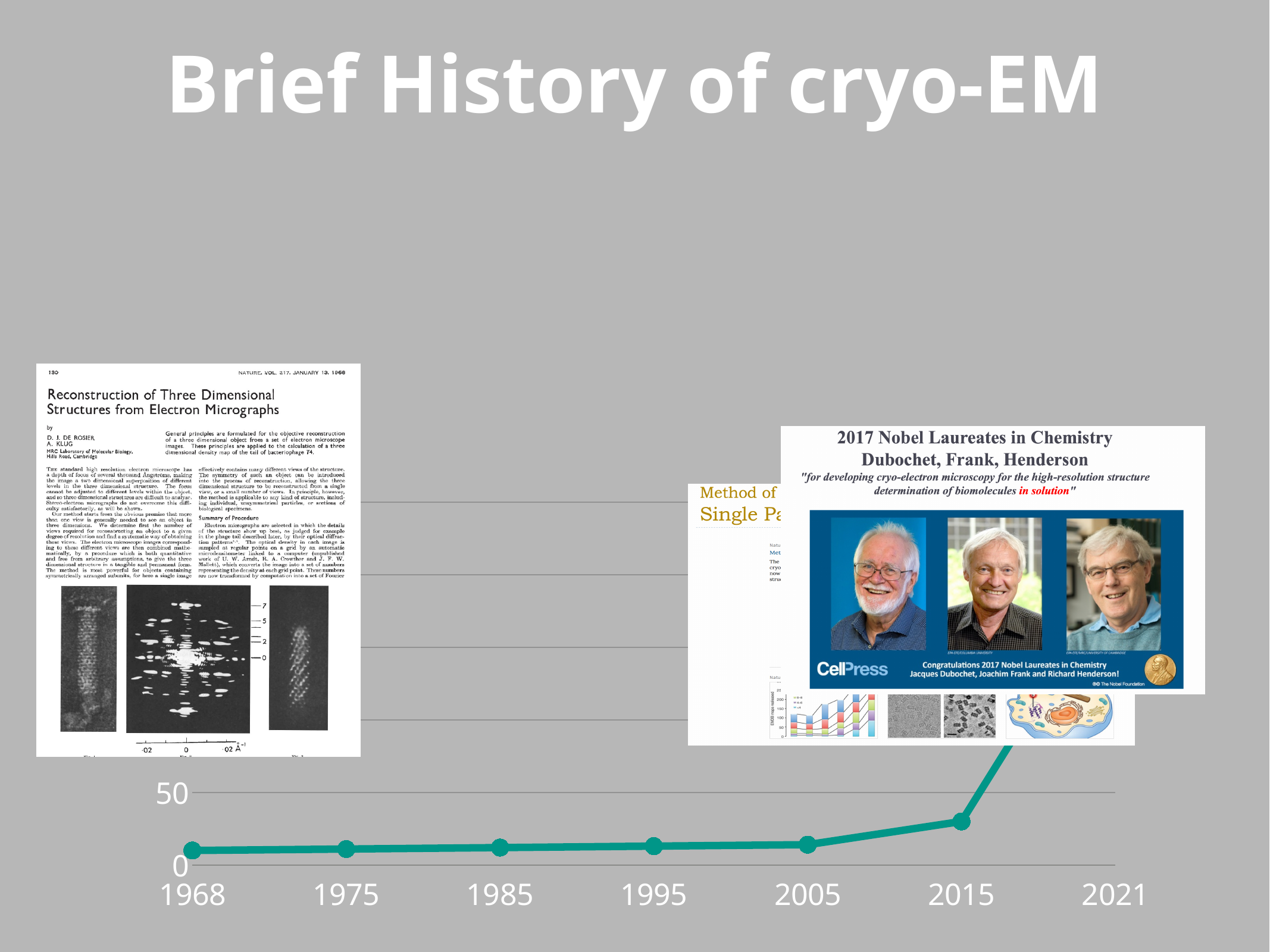
Is the value for 2005 greater or less than 50? less Which has the larger value, 1968 or 2015? 2015 Which has the larger value, 2005 or 2015? 2015 How many year labels are shown along the x axis of the chart? 7 Overall, do the values on the chart rise or fall along the x axis from 1968 onward? rise What kind of chart is shown on the slide? line chart What is the title of the slide containing the chart? Brief History of cryo-EM What is the first year shown on the x axis of the chart? 1968 Is the value for 2015 greater or less than 50? less Do the values on the chart rise or fall from 2005 to 2015? rise